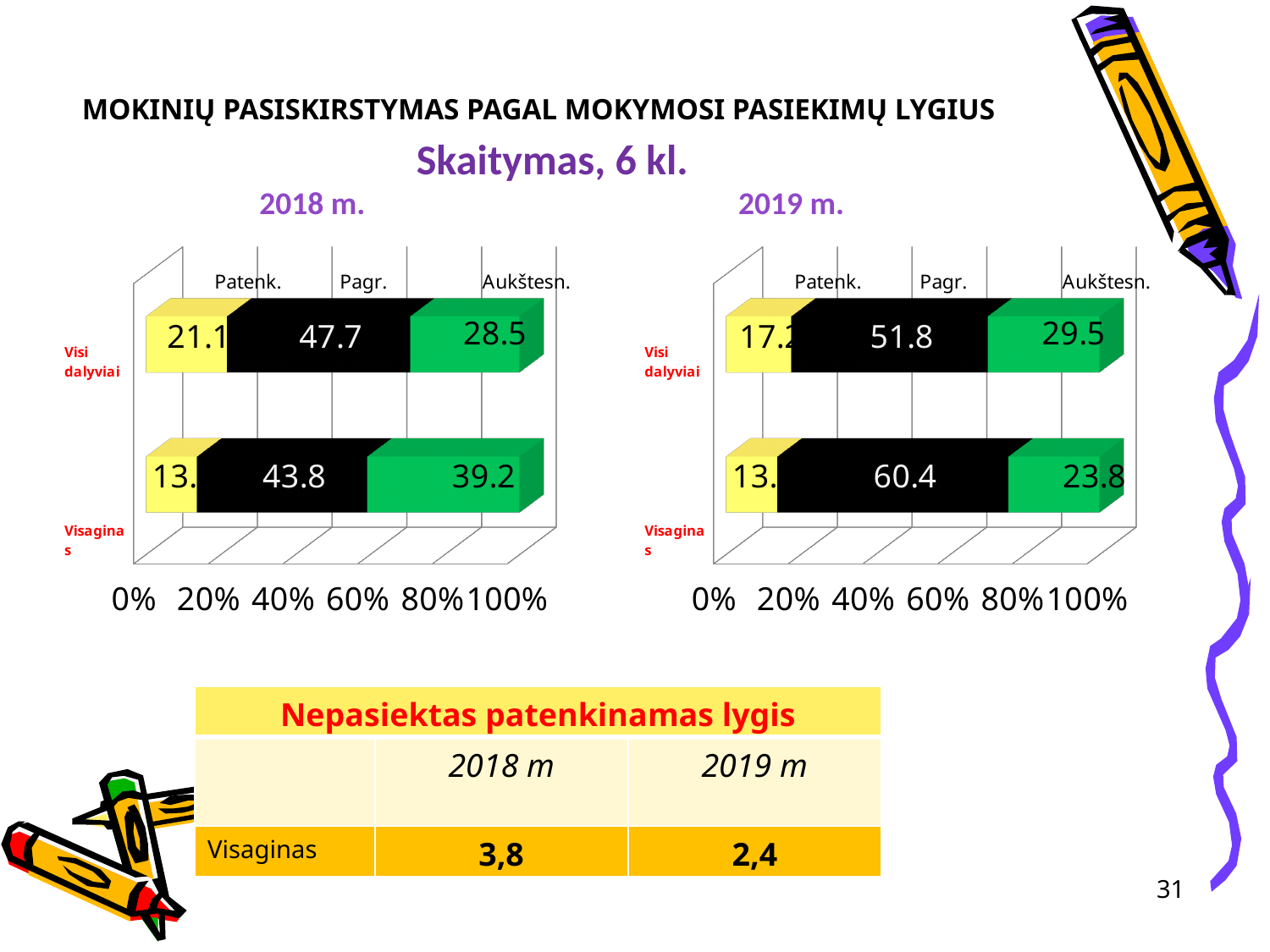
Which is larger: the Aukštesn. value for Visaginas in 2018 m. or in 2019 m.? 2018 m. In the 2019 m. chart, what is the Aukštesn. value for Visi dalyviai? 29.5 In the 2019 m. chart, which segment of the Visaginas bar is the largest? Pagr. What type of chart is used for the 2018 m. and 2019 m. data? Stacked bar chart In the 2019 m. chart, what is the Aukštesn. value for Visaginas? 23.8 How many series does each chart show? 3 In the 2018 m. chart, what is the Pagr. value for Visi dalyviai? 47.7 In the 2018 m. chart, what is the Patenk. value for Visi dalyviai? 21.1 In the 2018 m. chart, what is the difference between the Pagr. values for Visi dalyviai and Visaginas? 3.9 In the 2019 m. chart, what is the difference between the Pagr. values for Visaginas and Visi dalyviai? 8.6 In the 2019 m. chart, what is the Pagr. value for Visaginas? 60.4 In the 2018 m. chart, what is the Aukštesn. value for Visaginas? 39.2